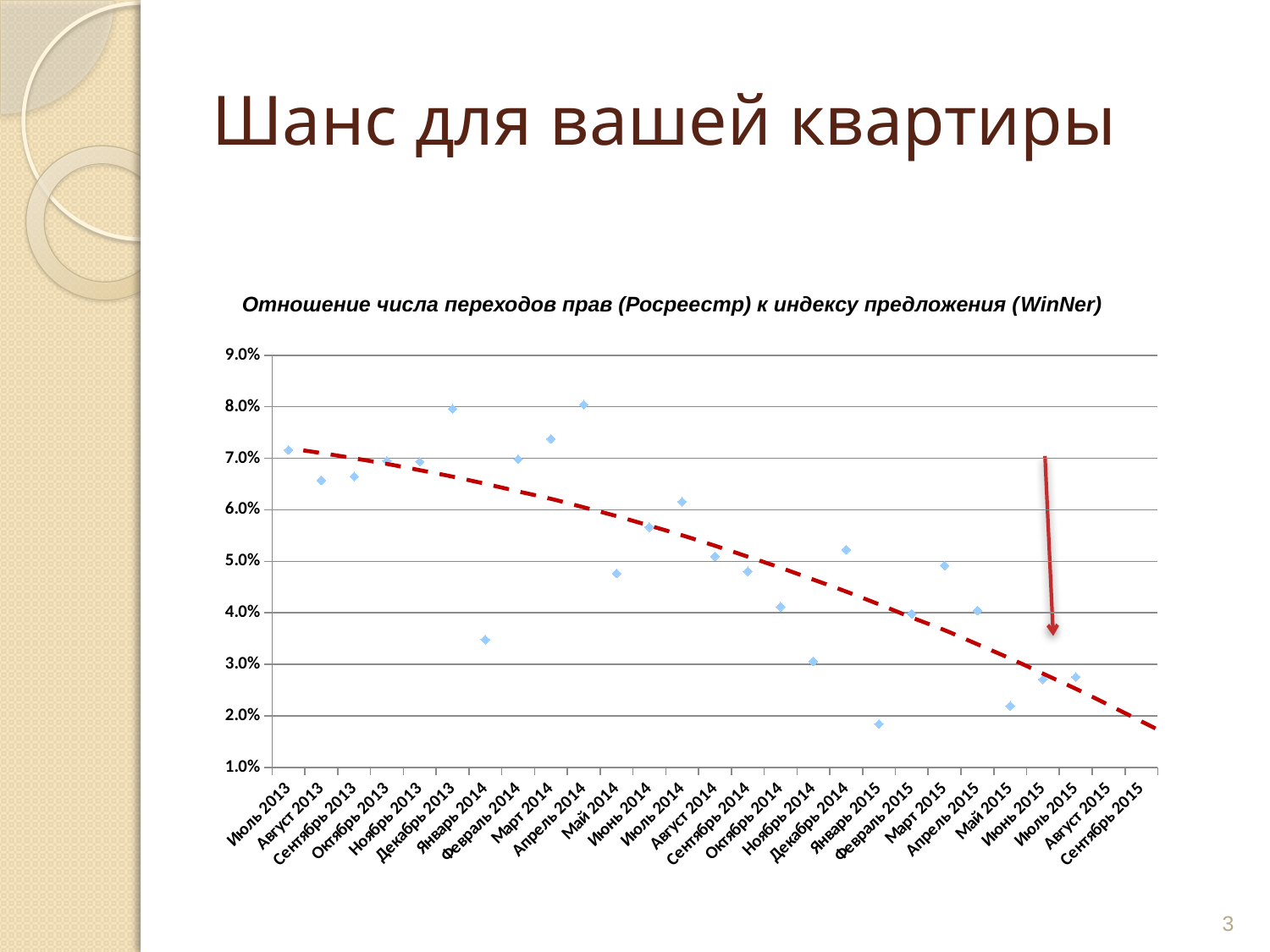
Is the value for Июль 2013 greater or less than 6.0%? greater Do the values generally rise or fall from Июль 2013 to Сентябрь 2015? Fall Which month has the lowest value? Январь 2015 Is the value for Ноябрь 2014 greater or less than 4.0%? less Is the value for Январь 2015 greater or less than 3.0%? less What is the title of the chart? Отношение числа переходов прав (Росреестр) к индексу предложения (WinNer) Which is larger, the value for Июль 2013 or the value for Июль 2015? Июль 2013 What kind of chart is shown on the slide? Scatter chart How many months are labelled on the x axis? 27